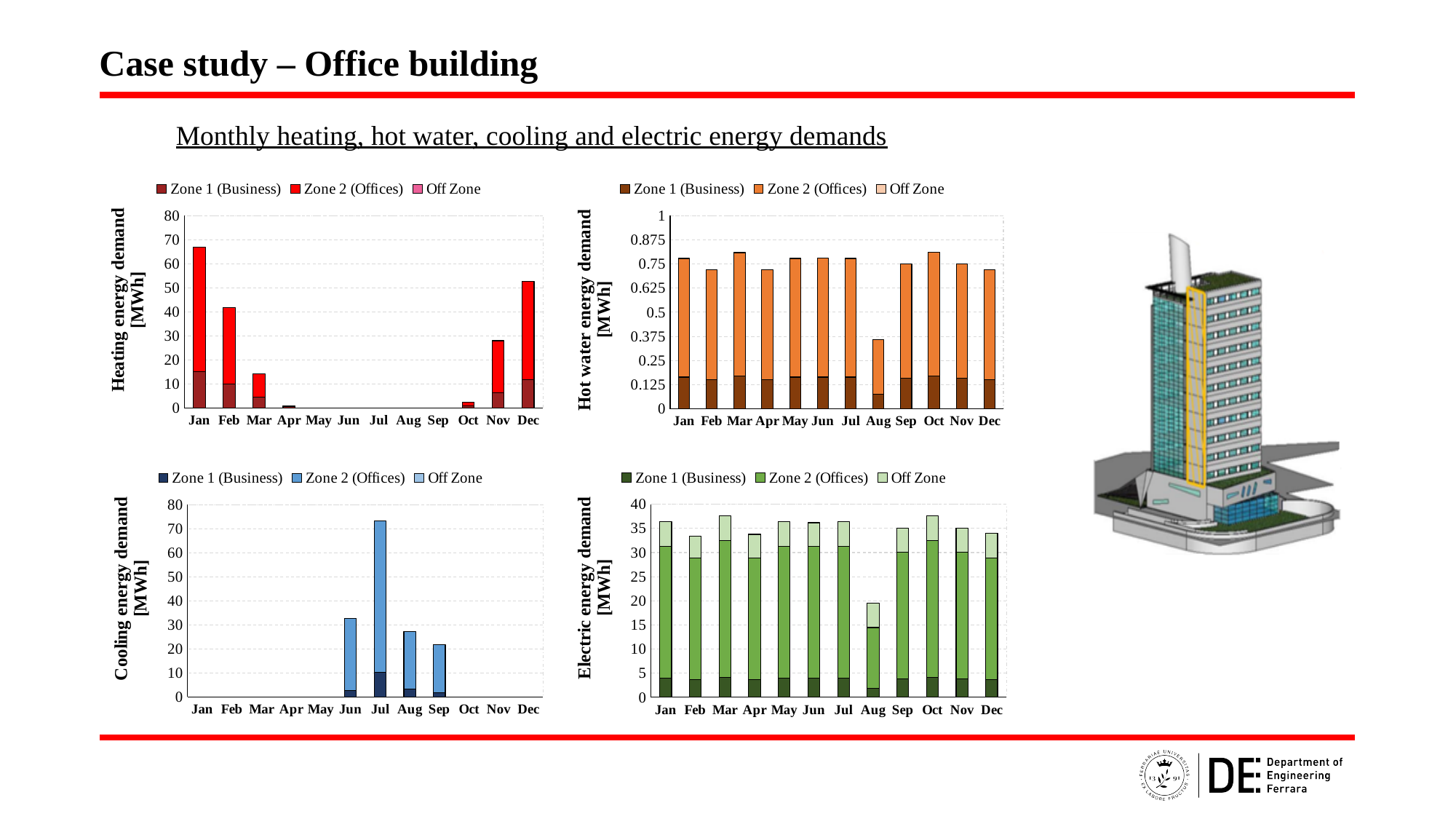
In the Cooling energy demand chart, is the total value for Sep greater or less than 30? less How many series does the legend of the Electric energy demand chart list? 3 In the Cooling energy demand chart, which month has the larger total cooling demand, Jun or Aug? Jun In the Hot water energy demand chart, which month has the lowest total hot water demand? Aug In the Heating energy demand chart, is the total value for Jan greater or less than 60? greater In the Hot water energy demand chart, is the total value for Aug greater or less than 0.5? less In the Cooling energy demand chart, which month has the highest total cooling demand? Jul In the Heating energy demand chart, which month has the highest total heating demand? Jan In the Electric energy demand chart, which month has the lowest total electric demand? Aug What kind of chart is the Heating energy demand chart? Bar chart